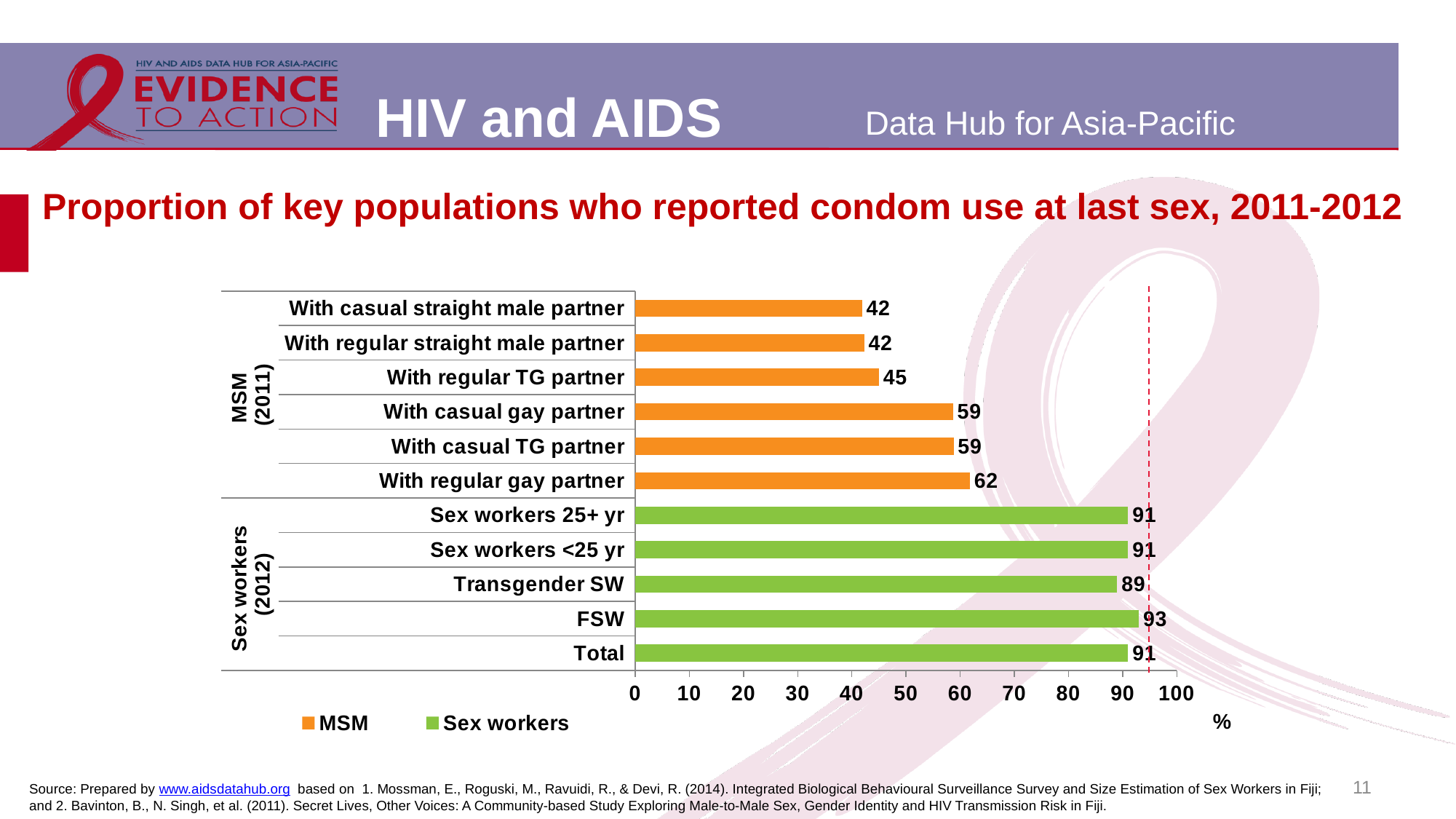
What is the value for Transgender SW? 89 What is the value for 'With regular TG partner'? 45 What is the value for FSW? 93 Which category has the highest value? FSW What is the difference between the values for FSW and 'With regular gay partner'? 31 Is the value for 'With casual straight male partner' greater or less than 50? less What is the value for 'With regular gay partner'? 62 Which is larger, the value for 'With casual gay partner' or 'With regular TG partner'? With casual gay partner How many series does the legend list? 2 What kind of chart is shown on the slide? bar chart How many categories are plotted on the chart? 11 Which category has the lowest value among the Sex workers (2012) group? Transgender SW